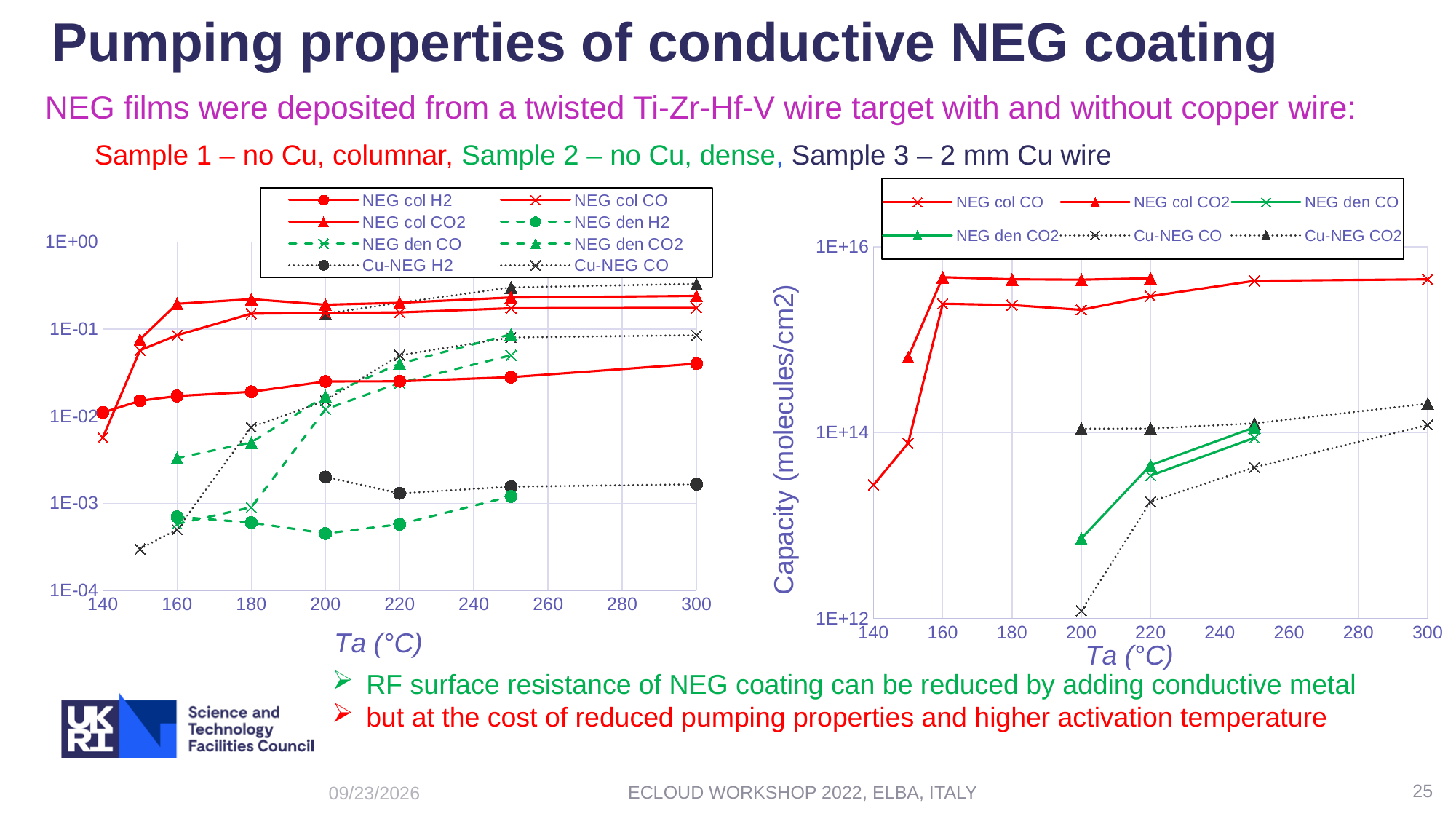
What is the y-axis title of the right-hand chart? Capacity (molecules/cm2) How many series does the legend of the right-hand chart list? 6 What kind of chart is the right-hand chart with the y-axis labelled Capacity (molecules/cm2)? line chart How many series does the legend of the left-hand chart list? 8 What is the x-axis title of the left-hand chart? Ta (°C) In the left-hand chart, which is larger at 300 °C: NEG col CO2 or Cu-NEG H2? NEG col CO2 In the left-hand chart, is the value of NEG den H2 at 200 °C greater or less than 1E-03? less In the right-hand chart, is the value of NEG col CO2 at 160 °C greater or less than 1E+16? less In the right-hand chart, which is larger at 300 °C: NEG col CO or Cu-NEG CO? NEG col CO In the right-hand chart, does the Cu-NEG CO series rise or fall as Ta increases from 200 °C to 300 °C? rise In the left-hand chart, is the value of NEG col CO2 at 160 °C greater or less than 1E-01? greater